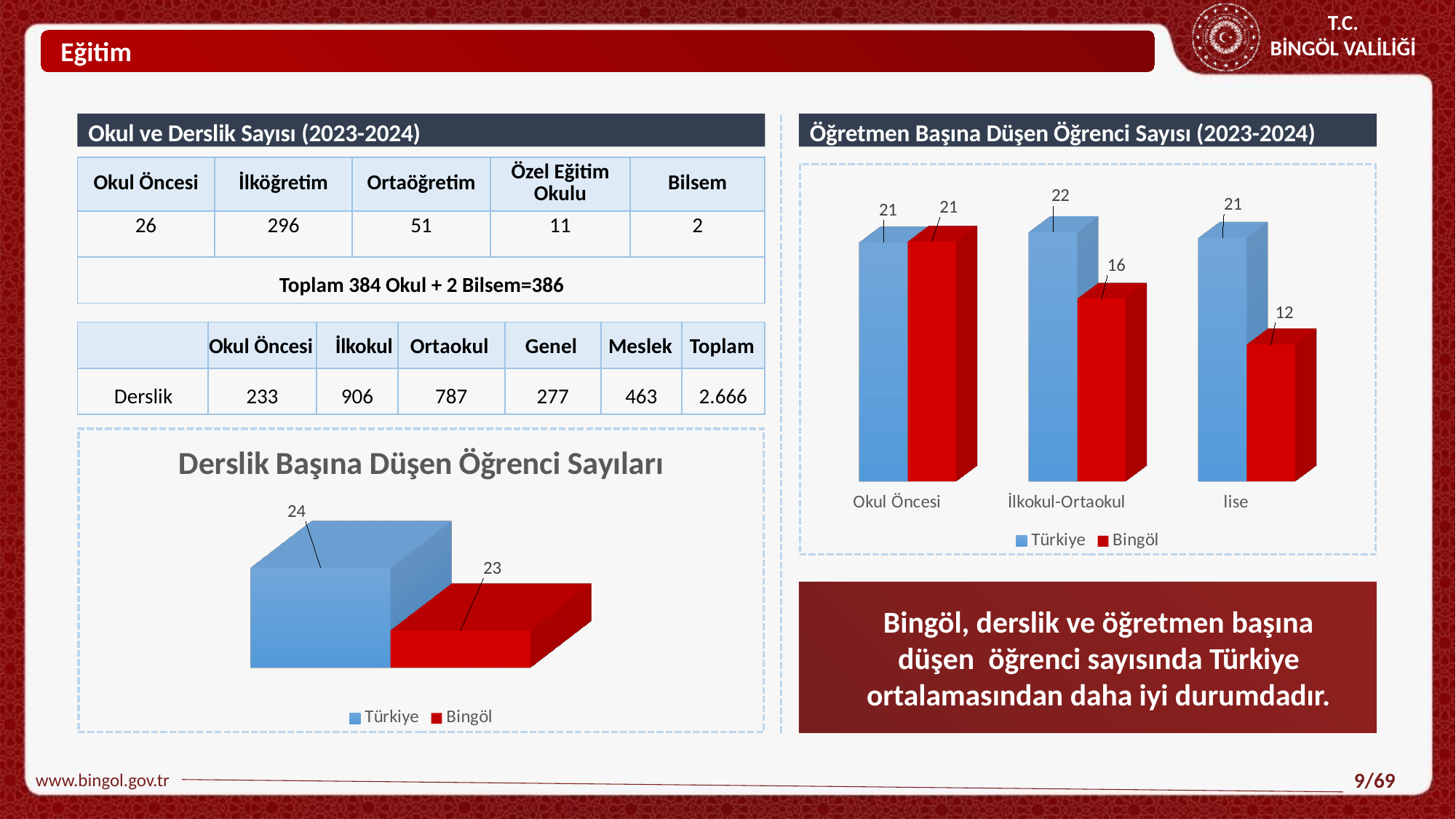
In the 'Derslik Başına Düşen Öğrenci Sayıları' chart, how many series does the legend list? 2 In the 'Öğretmen Başına Düşen Öğrenci Sayısı (2023-2024)' chart, what is the Bingöl value for Okul Öncesi? 21 In the 'Öğretmen Başına Düşen Öğrenci Sayısı (2023-2024)' chart, what is the Türkiye value for lise? 21 In the 'Öğretmen Başına Düşen Öğrenci Sayısı (2023-2024)' chart, how many categories are shown on the x axis? 3 In the 'Öğretmen Başına Düşen Öğrenci Sayısı (2023-2024)' chart, what is the Bingöl value for İlkokul-Ortaokul? 16 What kind of chart is the 'Öğretmen Başına Düşen Öğrenci Sayısı (2023-2024)' chart? Bar chart In the 'Derslik Başına Düşen Öğrenci Sayıları' chart, what is the value for Bingöl? 23 In the 'Öğretmen Başına Düşen Öğrenci Sayısı (2023-2024)' chart, which category has the highest Türkiye value? İlkokul-Ortaokul In the 'Derslik Başına Düşen Öğrenci Sayıları' chart, what is the value for Türkiye? 24 In the 'Öğretmen Başına Düşen Öğrenci Sayısı (2023-2024)' chart, which category has the lowest Bingöl value? lise In the 'Derslik Başına Düşen Öğrenci Sayıları' chart, what is the difference between the Türkiye and Bingöl values? 1 In the 'Öğretmen Başına Düşen Öğrenci Sayısı (2023-2024)' chart, what is the difference between the Türkiye and Bingöl values for lise? 9